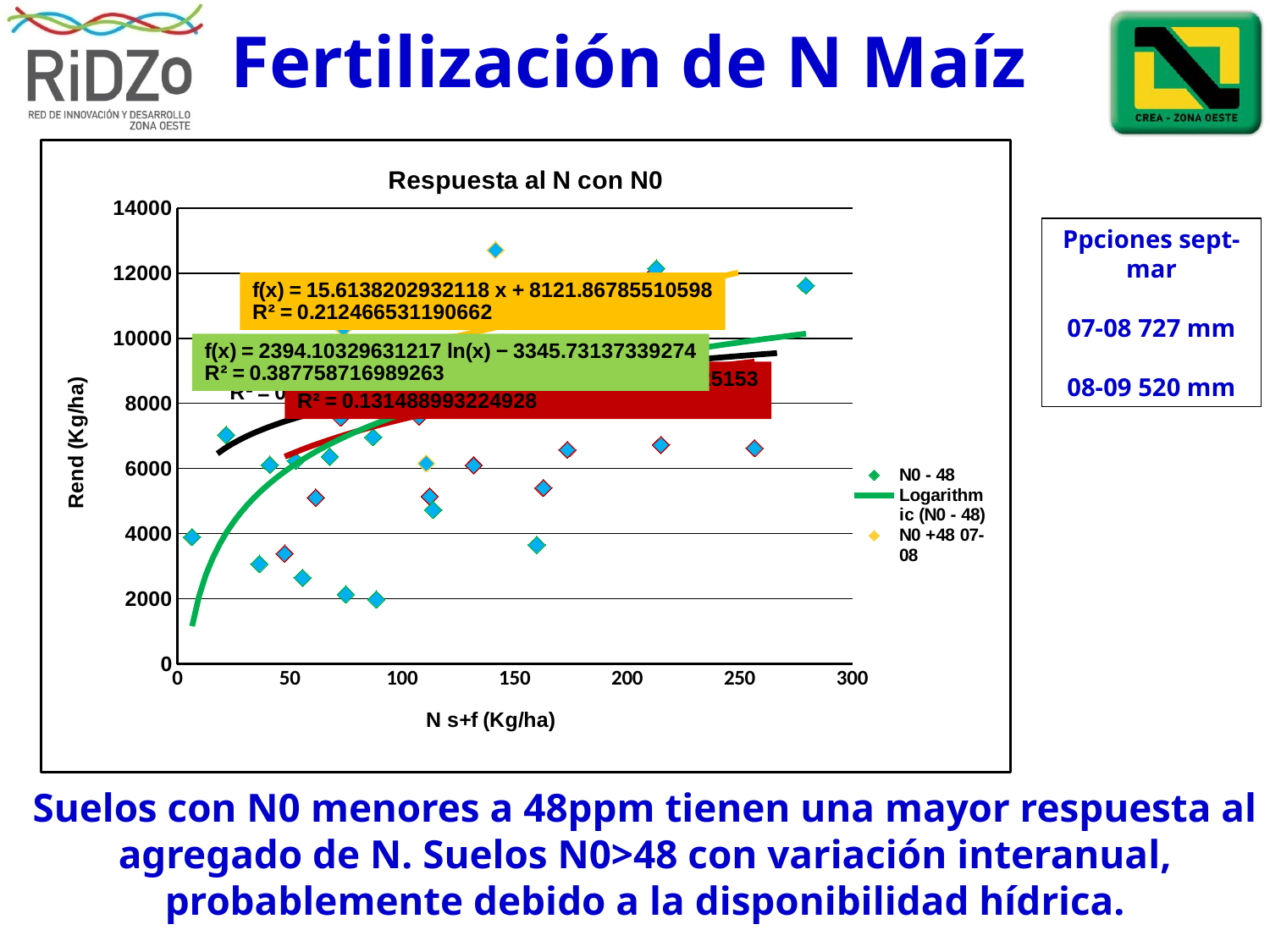
What is the R² value shown in the red box in the chart? 0.131488993224928 What is the maximum value shown on the x axis of the chart? 300 What is the R² value shown for the logarithmic fit (green box) in the chart? 0.387758716989263 What is the maximum value shown on the y axis of the chart? 14000 What is the label of the x axis of the chart? N s+f (Kg/ha) What is the title of the chart? Respuesta al N con N0 Is the highest plotted point in the chart greater or less than 12000 Kg/ha? greater How many entries does the chart legend list? 3 What is the linear equation shown in the yellow box in the chart? f(x) = 15.6138202932118 x + 8121.86785510598 What kind of chart is shown on the slide? Scatter chart What is the R² value shown in the yellow equation box in the chart? 0.212466531190662 Does the green logarithmic trendline rise or fall as N s+f increases? Rises